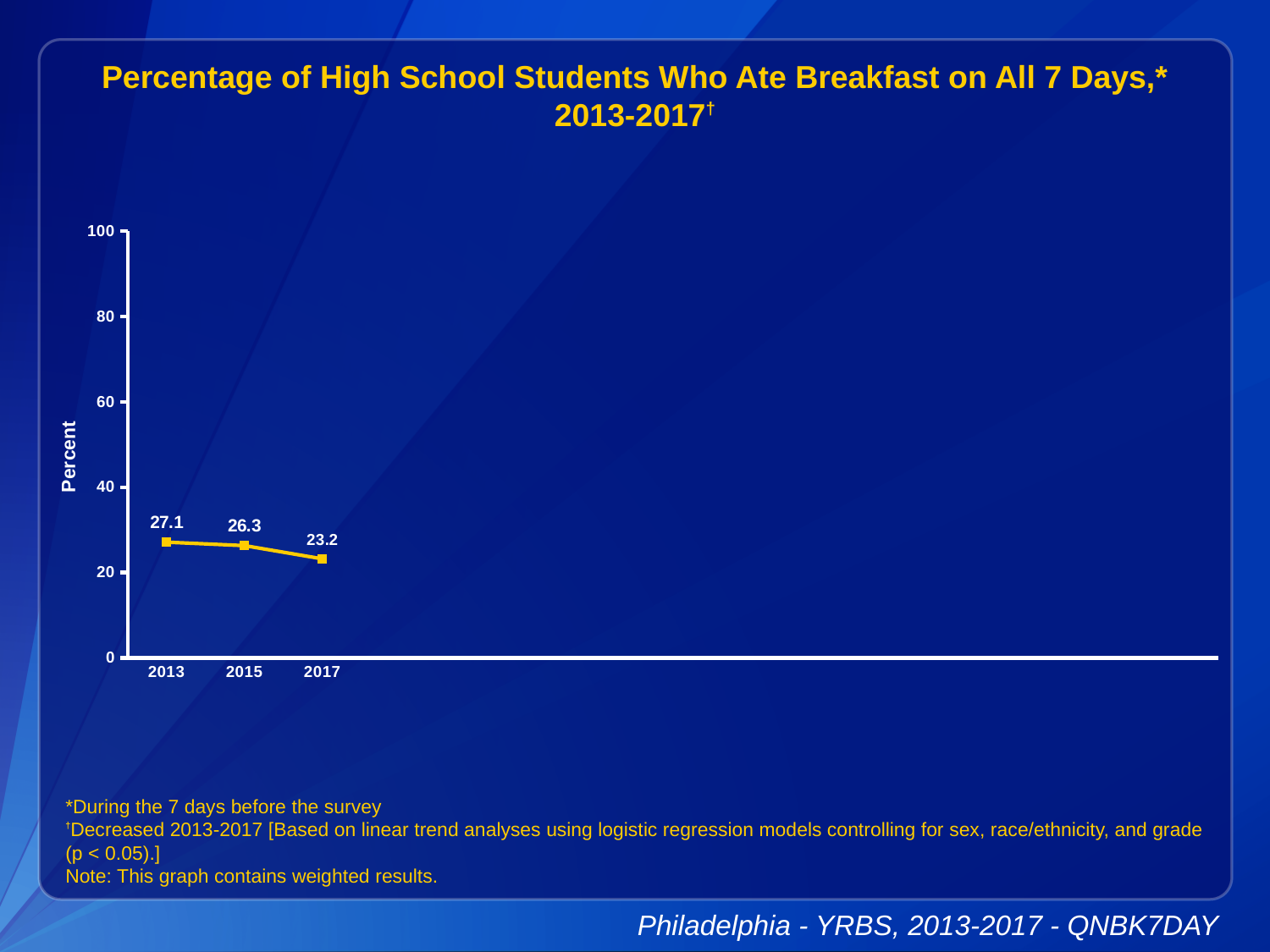
What kind of chart is shown on the slide? line chart What is the difference between the 2013 and 2017 values? 3.9 Which year has a larger value, 2015 or 2017? 2015 What percentage of high school students ate breakfast on all 7 days in 2017? 23.2 What is the difference between the 2015 and 2017 values? 3.1 Do the values rise or fall from 2013 to 2017? fall What percentage of high school students ate breakfast on all 7 days in 2015? 26.3 Is the value for 2017 greater or less than 40? less What percentage of high school students ate breakfast on all 7 days in 2013? 27.1 Which year has the highest percentage of students who ate breakfast on all 7 days? 2013 Which year has the lowest percentage of students who ate breakfast on all 7 days? 2017 How many years are plotted on the chart? 3